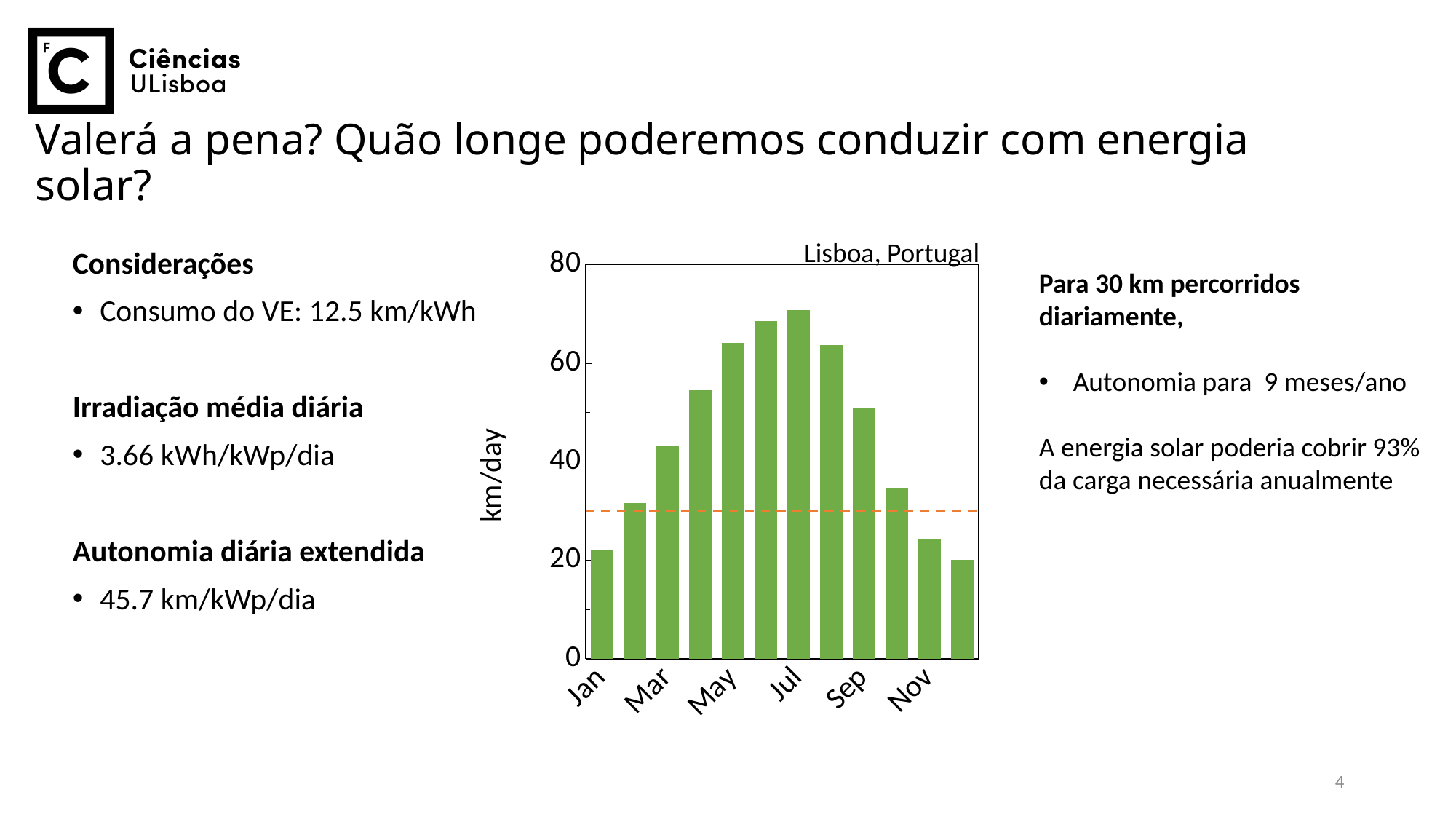
Is the value for Nov greater or less than 40 km/day? less What location is named in the chart's title? Lisboa, Portugal Which month has the highest value in the chart? Jul Which is larger, the value for Jul or the value for Jan? Jul Do the values rise or fall from Jan to Jul? rise Is the value for May greater or less than 60 km/day? greater What is the label on the y axis of the chart? km/day What kind of chart is shown on the slide? bar chart Is the value for Sep greater or less than 40 km/day? greater How many bars (months) are plotted in the chart? 12